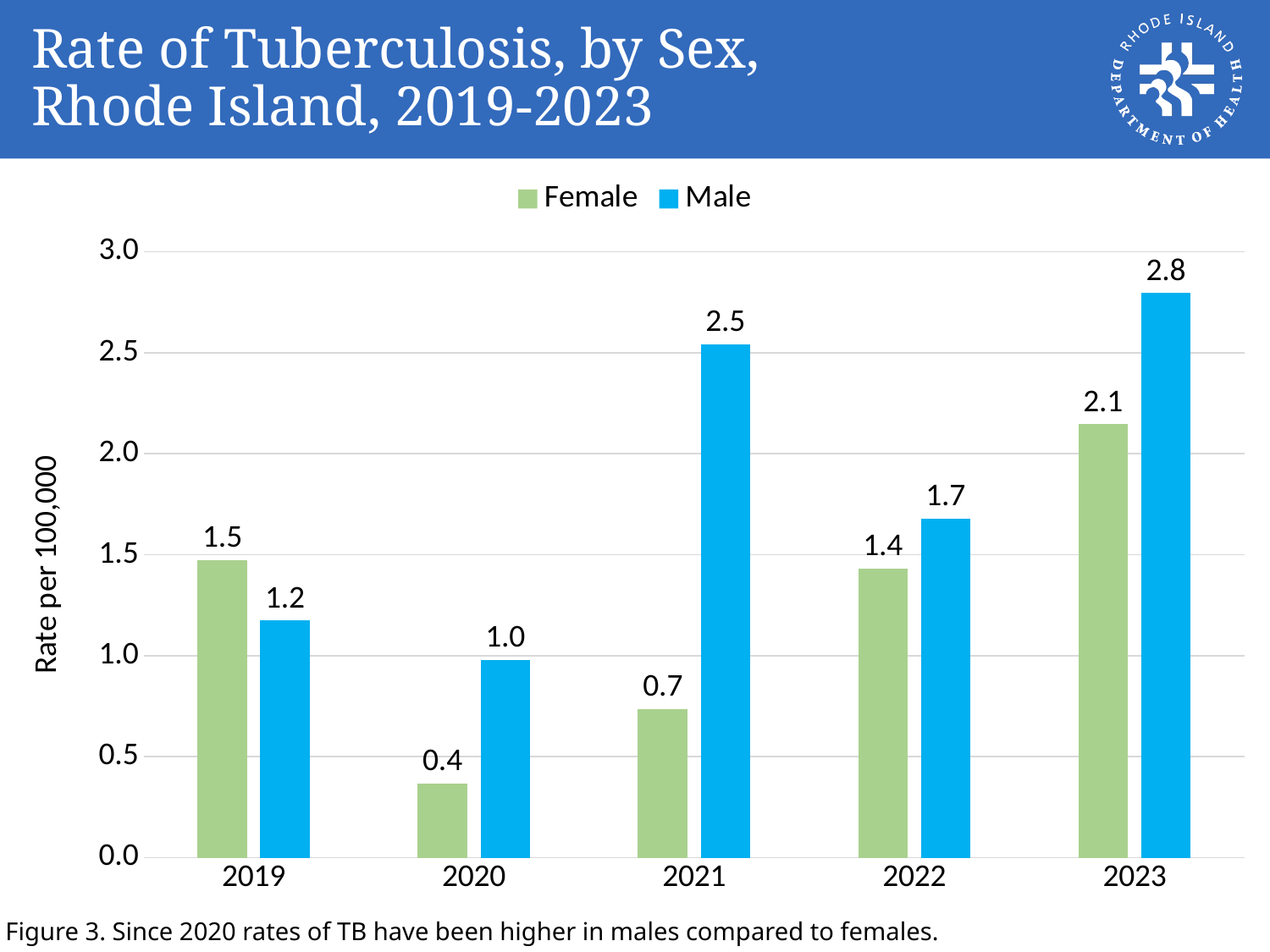
What is the tuberculosis rate for females in 2019? 1.5 In which year is the female tuberculosis rate lowest? 2020 Which is larger in 2019, the female rate or the male rate? Female How many series does the legend list? 2 What kind of chart is shown on the slide? Bar chart How many years are shown on the x axis? 5 What is the difference between the male and female tuberculosis rates in 2021? 1.8 Is the male tuberculosis rate in 2022 greater or less than 1.5? greater What is the tuberculosis rate for females in 2020? 0.4 What is the label of the y axis? Rate per 100,000 What is the tuberculosis rate for males in 2021? 2.5 In which year is the male tuberculosis rate highest? 2023